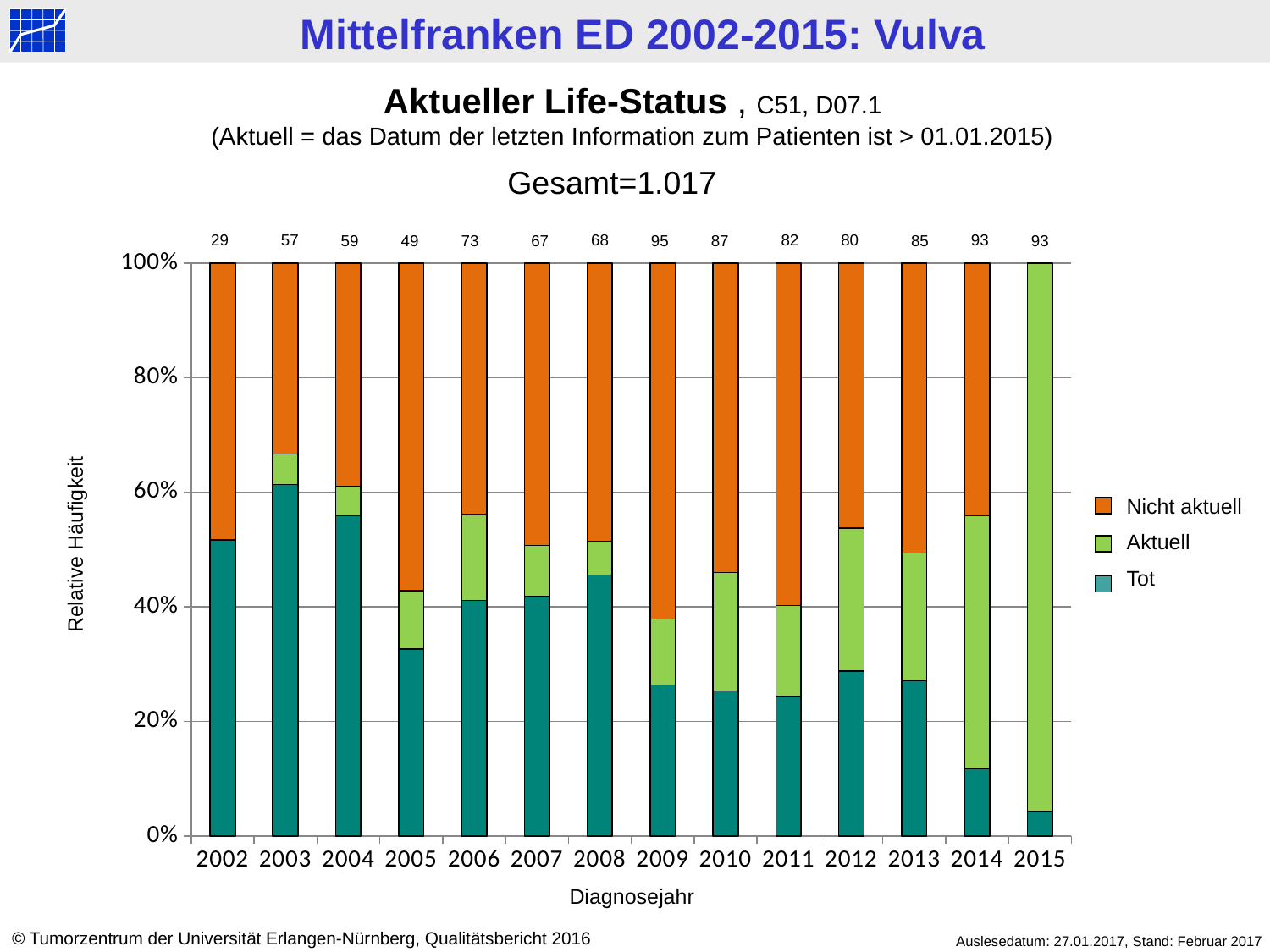
Which diagnosis year has the lowest number of cases printed above its bar? 2002 Which diagnosis year has the highest number of cases printed above its bar? 2009 How many diagnosis years are shown on the x axis? 14 Which year has more cases printed above its bar, 2006 or 2011? 2011 What is the difference between the case counts printed for 2009 and 2002? 66 Which year has a larger 'Tot' share, 2003 or 2015? 2003 What kind of chart is shown on the slide? Stacked bar chart How many cases are shown above the bar for 2009? 95 How many series does the legend list? 3 Is the 'Tot' share for 2002 greater or less than 40%? greater Is the 'Tot' share for 2014 greater or less than 20%? less What is the number printed above the bar for 2002? 29